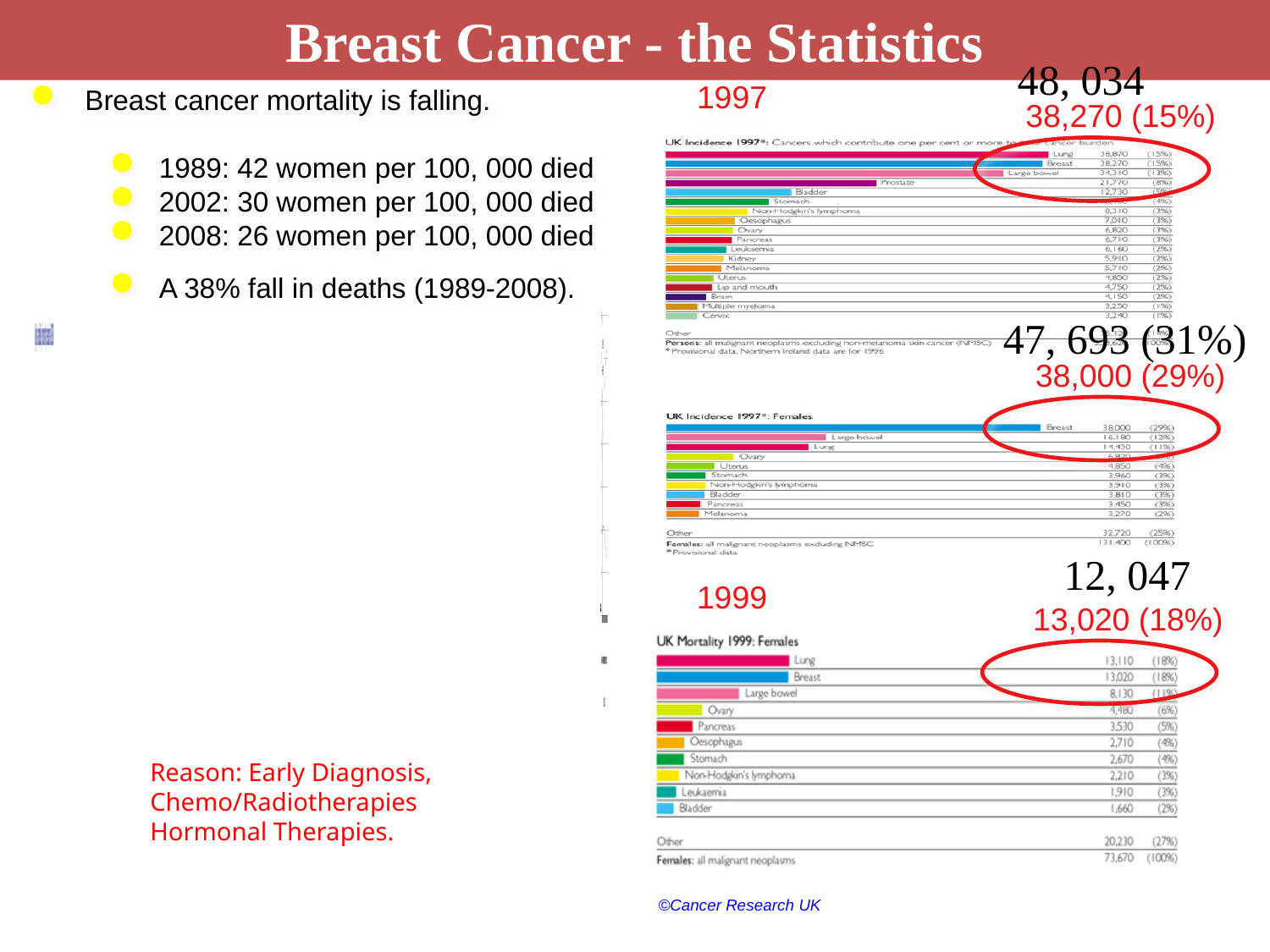
In the UK Mortality 1999: Females chart, what is the value for Ovary? 4,480 In the UK Incidence 1997: Females chart, what percentage share does Breast account for? 29% In the UK Mortality 1999: Females chart, what is the difference between the Lung and Breast values? 90 In the UK Mortality 1999: Females chart, do the bar values rise or fall going down the chart from Lung to Bladder? Fall What kind of chart is the UK Mortality 1999: Females chart? Bar chart In the UK Mortality 1999: Females chart, which cancer has the lowest number of deaths? Bladder In the UK Mortality 1999: Females chart, what is the value for Breast? 13,020 How many cancer categories are plotted as bars in the UK Mortality 1999: Females chart? 10 In the UK Incidence 1997: Females chart, which is larger, Large bowel or Lung? Large bowel In the UK Incidence 1997: Females chart, what is the value for Breast? 38,000 In the UK Mortality 1999: Females chart, what percentage is shown for Large bowel? 11% In the UK Mortality 1999: Females chart, which cancer has the highest number of deaths? Lung